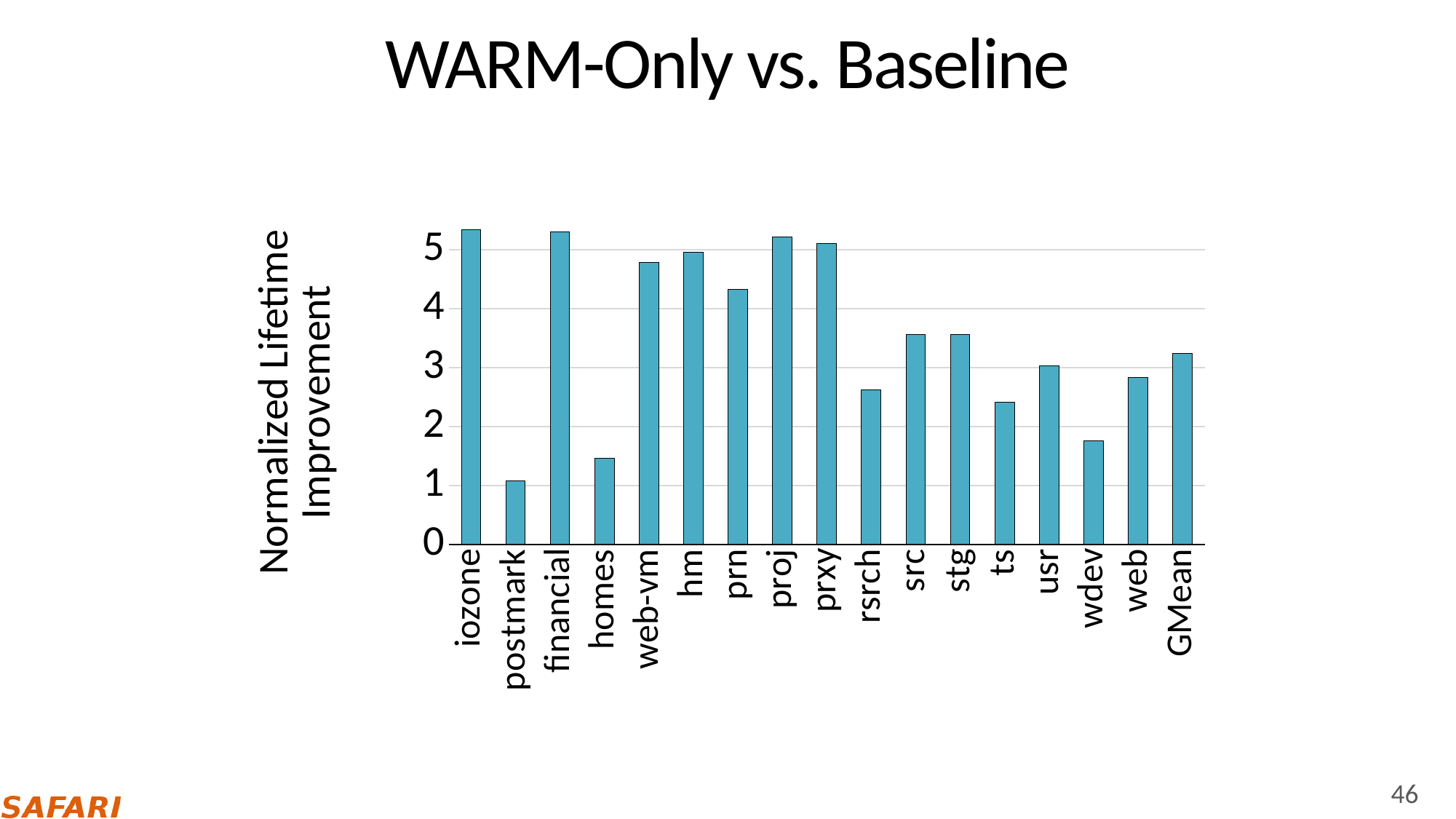
Which has a larger value, prn or rsrch? prn How many categories are plotted along the x axis? 17 Which has a larger value, homes or wdev? wdev What is the label on the y axis? Normalized Lifetime Improvement What is the title of the chart? WARM-Only vs. Baseline What kind of chart is shown on the slide? bar chart Is the value for rsrch greater or less than 3? less Which category has the lowest normalized lifetime improvement? postmark Is the value for web-vm greater or less than 4? greater Is the value for wdev greater or less than 2? less